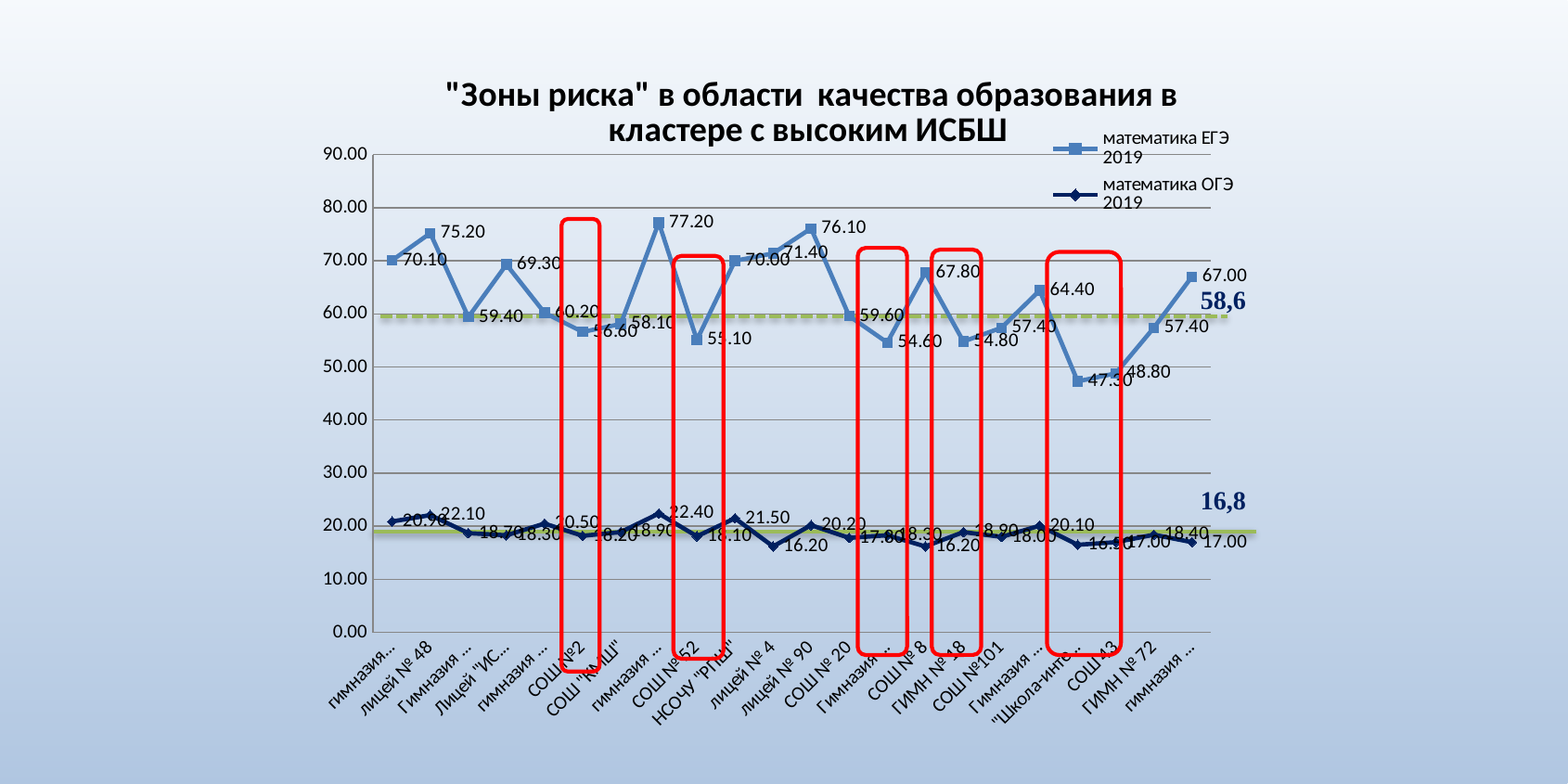
Is the математика ЕГЭ 2019 value for лицей № 90 greater or less than 70? greater What is the highest value in the математика ЕГЭ 2019 series? 77.20 What value is marked on the dashed horizontal reference line for the ЕГЭ series? 58,6 What is the lowest value in the математика ЕГЭ 2019 series? 47.30 What is the value of математика ЕГЭ 2019 for СОШ 43? 48.80 How much higher is the математика ЕГЭ 2019 value for лицей № 48 than for СОШ №2? 18.60 What is the value of математика ЕГЭ 2019 for лицей № 48? 75.20 What is the value of математика ОГЭ 2019 for лицей № 90? 20.20 What is the value of математика ЕГЭ 2019 for СОШ № 52? 55.10 How many series does the legend list? 2 What kind of chart is shown on the slide? line chart